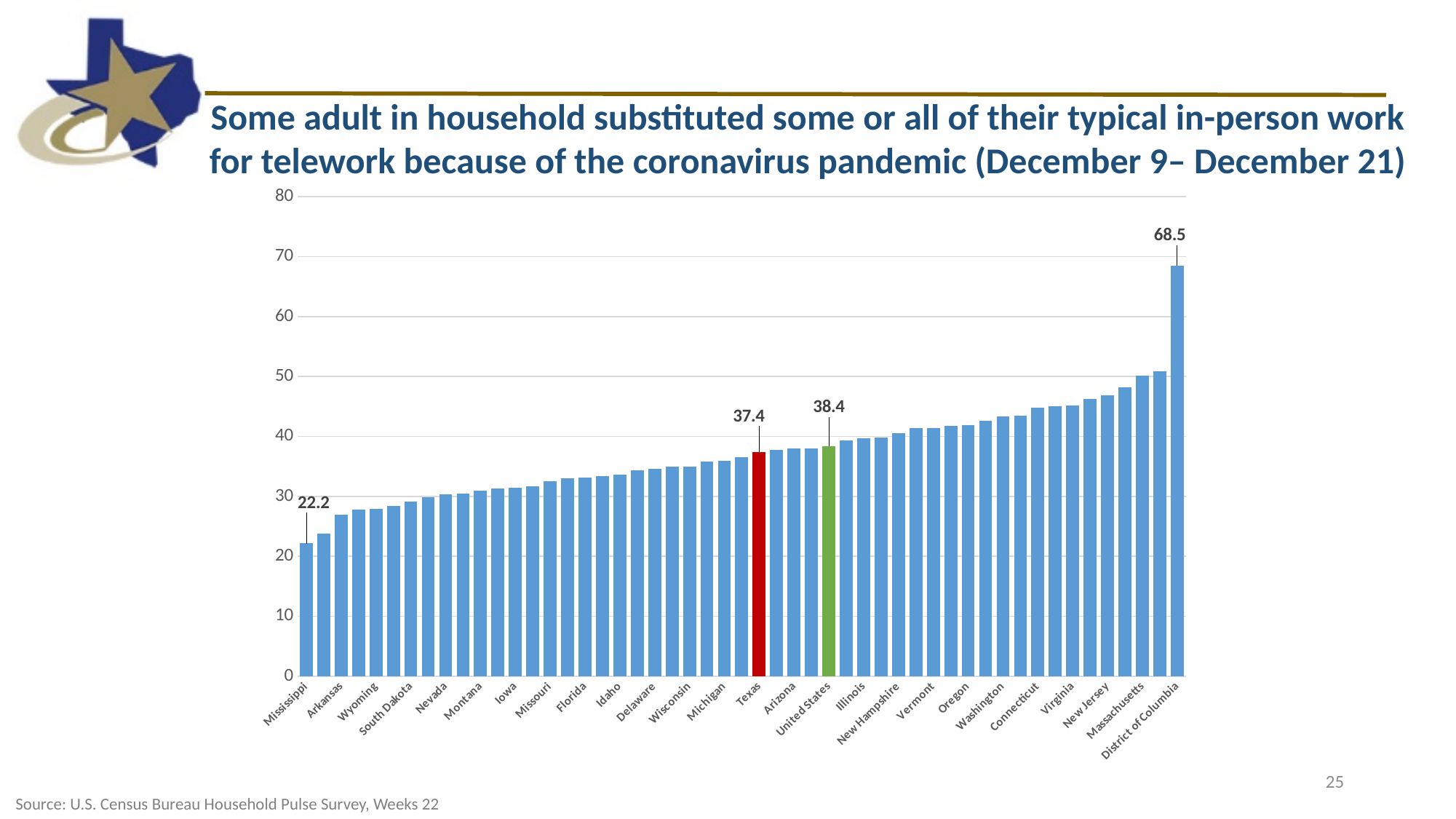
Is the value for Wyoming greater or less than 30? less Which category has the highest value? District of Columbia What is the difference between the District of Columbia value and the Mississippi value? 46.3 Is the value for New Jersey greater or less than 50? less What kind of chart is shown on the slide? bar chart Which category has the lowest value? Mississippi What is the value for the District of Columbia? 68.5 What is the value for the United States? 38.4 What is the value for Mississippi? 22.2 What is the difference between the United States value and the Texas value? 1.0 Which is larger, the value for Texas or the value for the United States? United States What is the value for Texas? 37.4